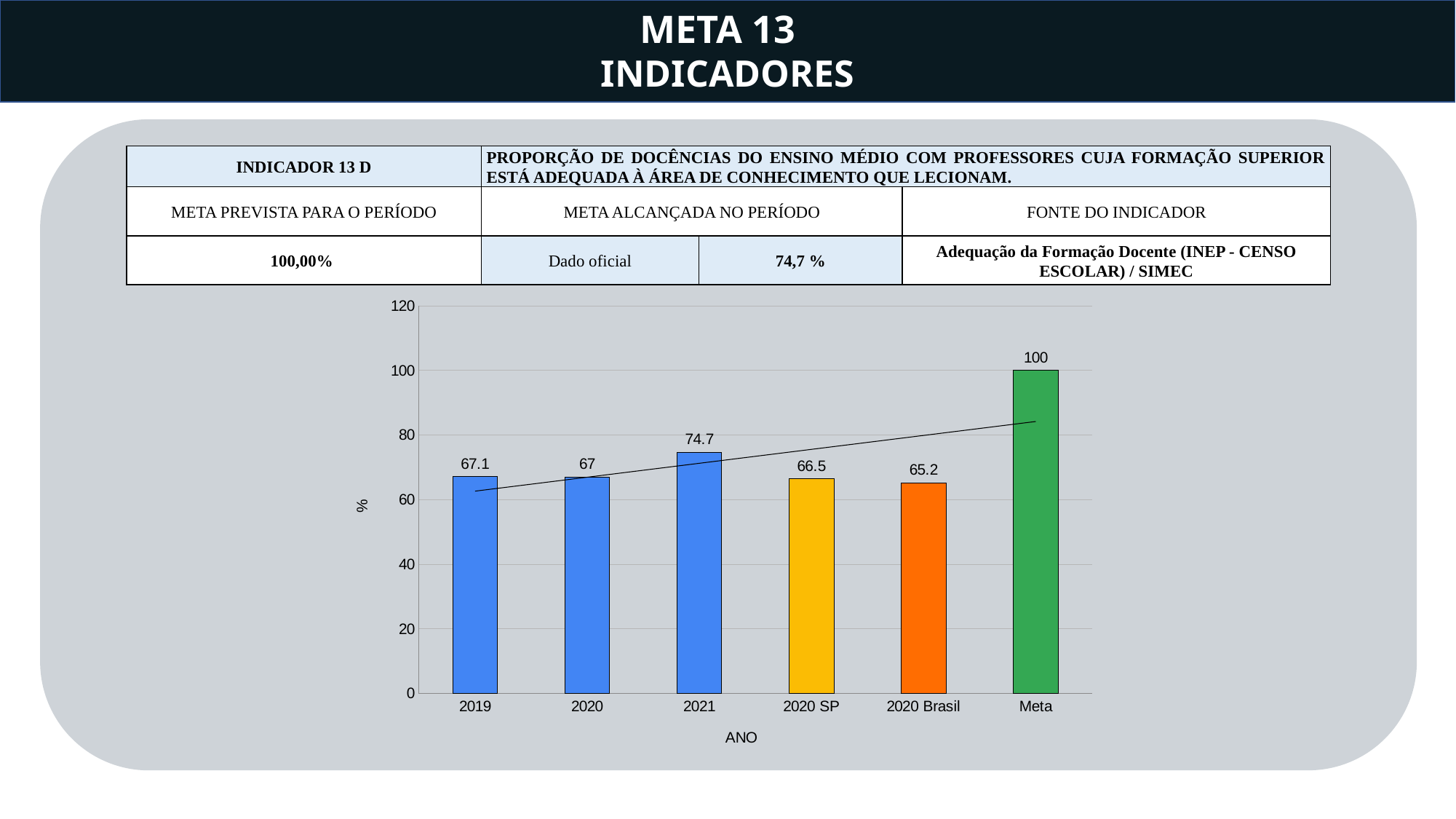
Which is larger, the value for 2020 SP or the value for 2020 Brasil? 2020 SP How many bars are shown in the chart? 6 What is the value for 2020 SP? 66.5 What is the value for 2020 Brasil? 65.2 What is the value for 2021? 74.7 Which category has the highest value? Meta What is the value for 2019? 67.1 Which category has the lowest value? 2020 Brasil What kind of chart is shown on the slide? bar chart Is the value for 2021 greater or less than 80? less What is the difference between the Meta value and the 2021 value? 25.3 What is the label of the x axis? ANO